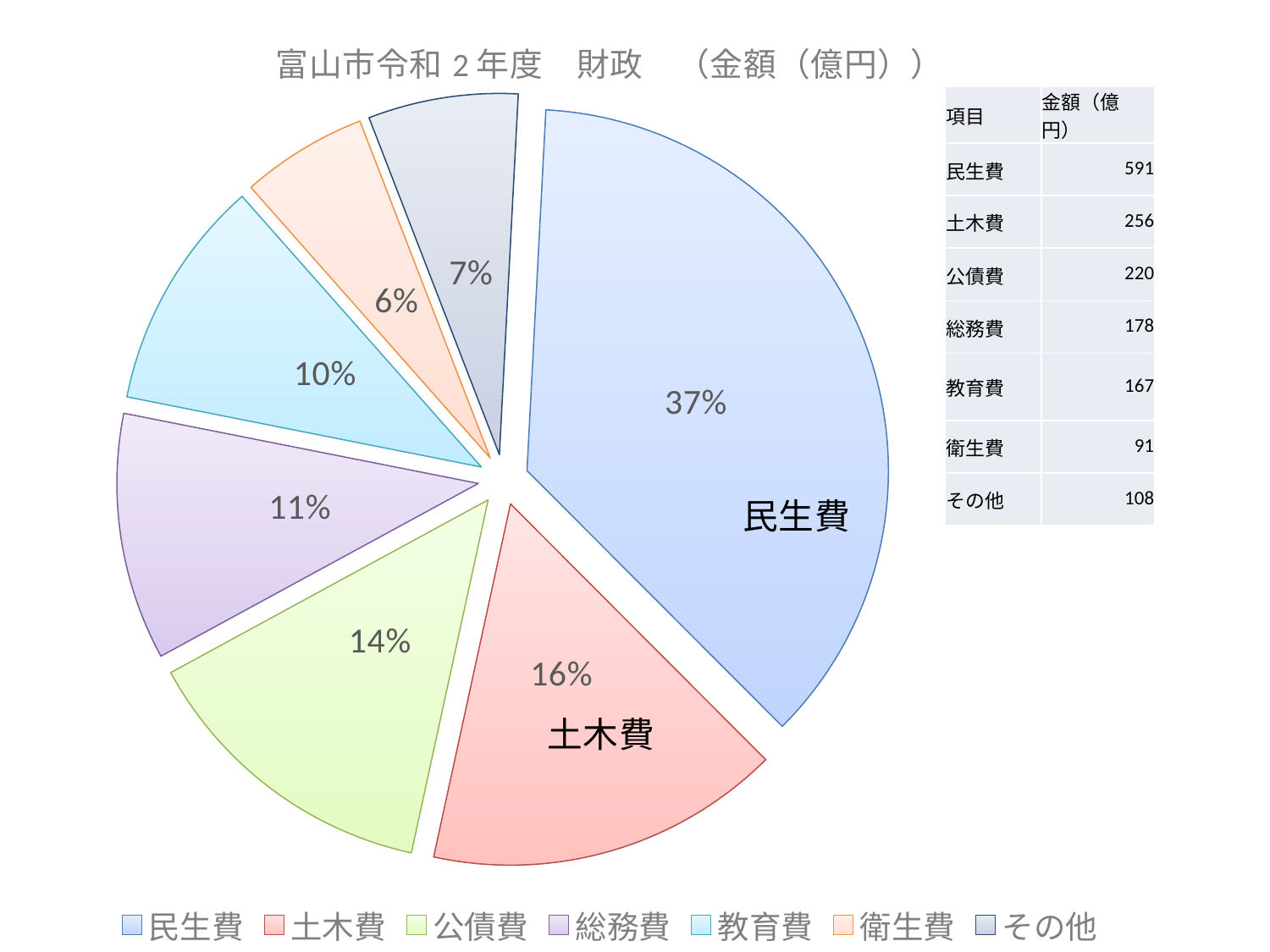
Which category has the smallest slice of the pie? 衛生費 According to the table, what is the amount (億円) for 総務費? 178 Which category has the largest slice of the pie? 民生費 What share of the pie does 民生費 represent? 37% What share of the pie does 教育費 represent? 10% What share of the pie does 土木費 represent? 16% What is the difference in amount (億円) between 民生費 and 土木費 according to the table? 335 According to the table, what is the amount (億円) for 公債費? 220 Which is larger, the slice for 公債費 or the slice for 総務費? 公債費 How many slices does the pie chart have? 7 What kind of chart is shown on the slide? pie chart